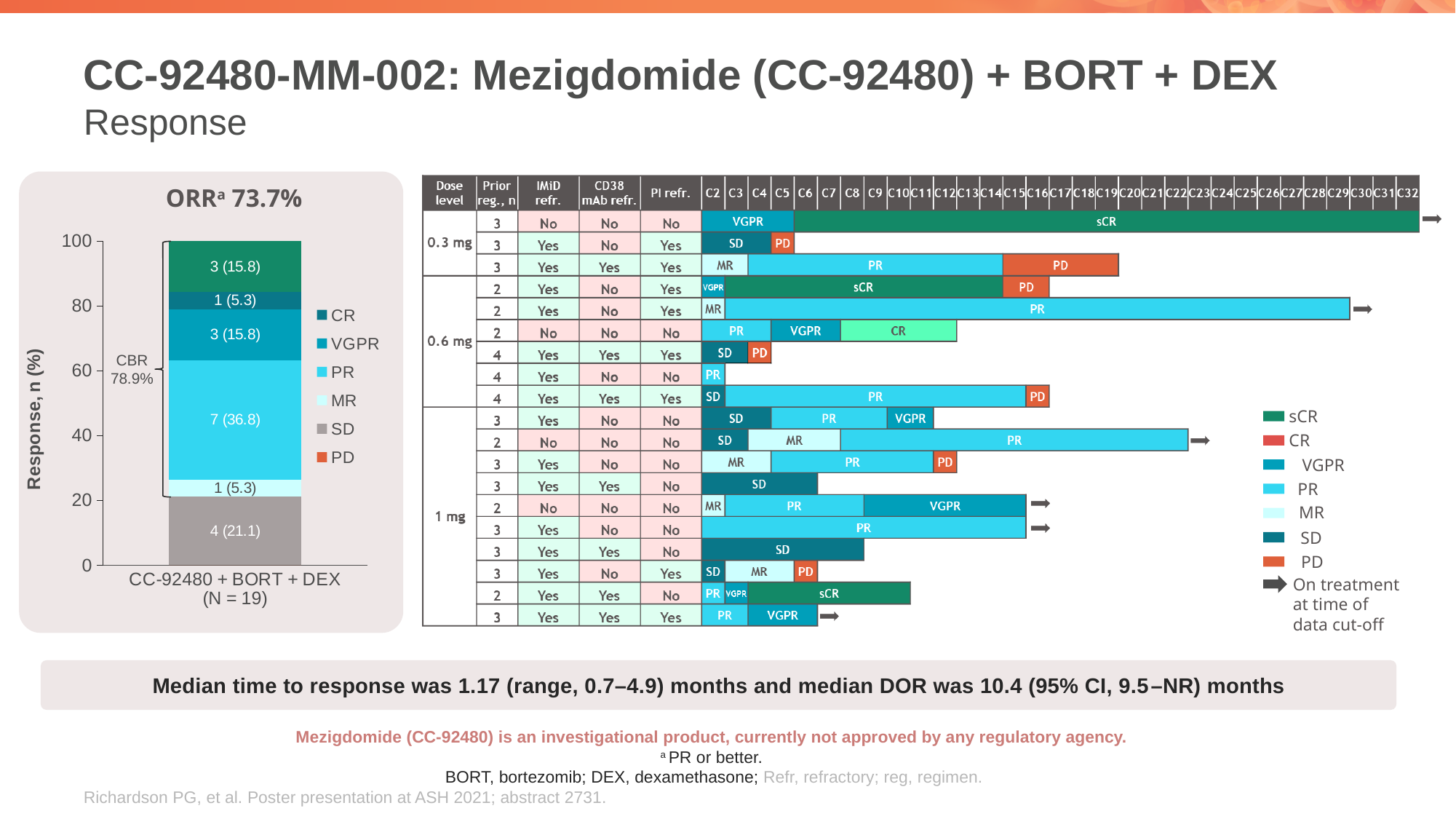
In the stacked bar chart on the left, which response category has the largest segment? PR What kind of chart is shown on the left of the slide? Stacked bar chart In the stacked bar chart on the left, what is the value labelled on the MR segment? 1 (5.3) In the stacked bar chart on the left, what ORR value is shown in the chart title? 73.7% In the stacked bar chart on the left, what is the value labelled on the VGPR segment? 3 (15.8) In the stacked bar chart on the left, what is the value labelled on the PR segment? 7 (36.8) In the stacked bar chart on the left, what is the value labelled on the SD segment? 4 (21.1) In the stacked bar chart on the left, how many entries does the legend list? 6 In the swimmer plot on the right, how many dose levels are shown? 3 In the stacked bar chart on the left, how many more patients had PR than SD? 3 In the stacked bar chart on the left, what is the CBR value shown beside the bar? 78.9% In the stacked bar chart on the left, which segment is larger, PR or SD? PR